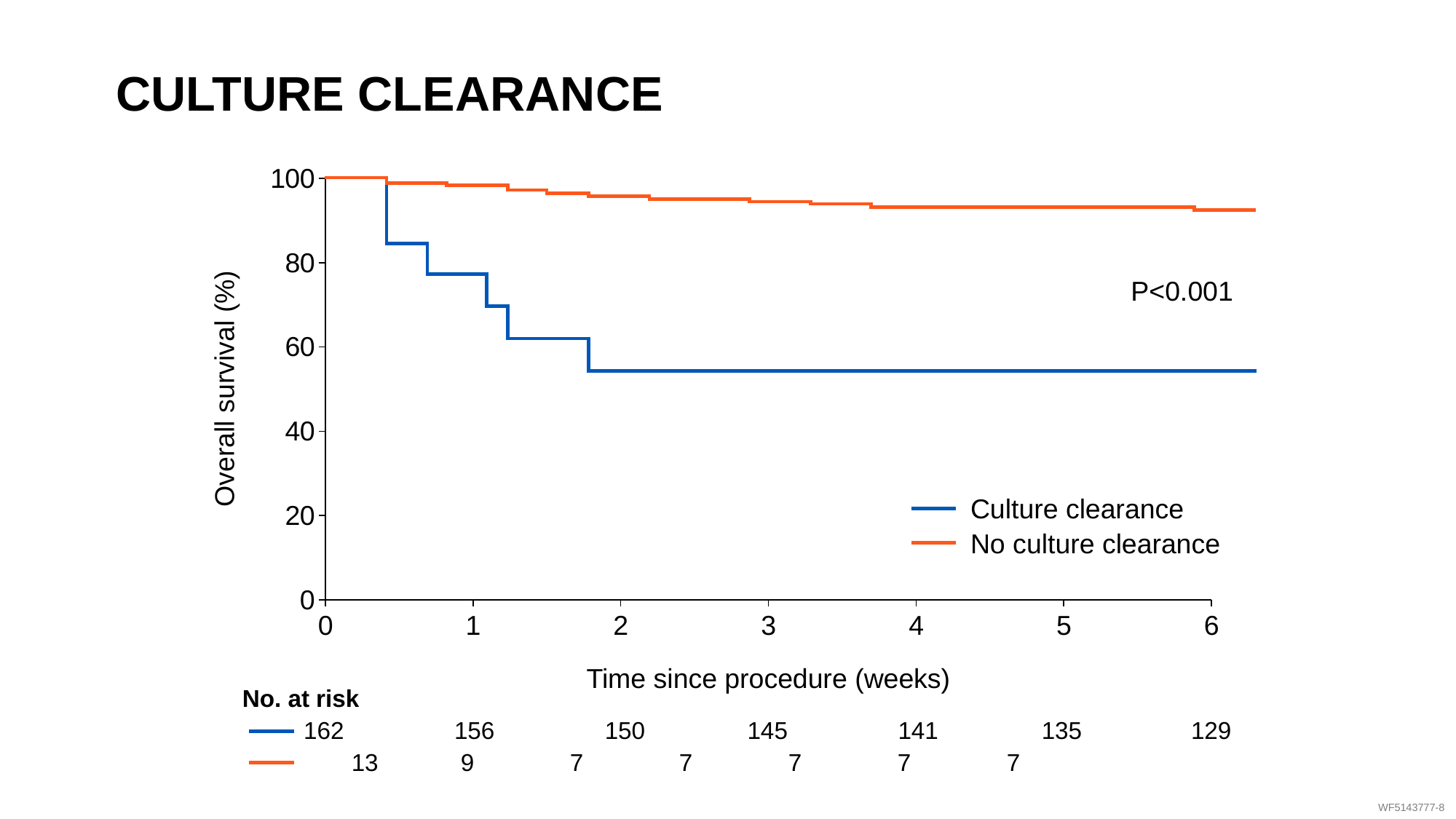
Does the Culture clearance curve rise or fall as time since procedure increases? fall Is the overall survival for Culture clearance at week 4 greater or less than 60? less What is the title of the chart? CULTURE CLEARANCE At week 3, which series has the higher overall survival, Culture clearance or No culture clearance? No culture clearance What kind of chart is shown on the slide? line chart In the No. at risk table, what is the number at risk for the orange (No culture clearance) series at week 0? 13 Is the overall survival for Culture clearance at week 1 greater or less than 60? greater What P value is printed on the chart? P<0.001 In the No. at risk table, what is the number at risk for the blue (Culture clearance) series at week 0? 162 How many series does the legend list? 2 In the No. at risk table, what is the difference between the first (162) and last (129) numbers at risk for the blue series? 33 Is the overall survival for No culture clearance at week 6 greater or less than 80? greater